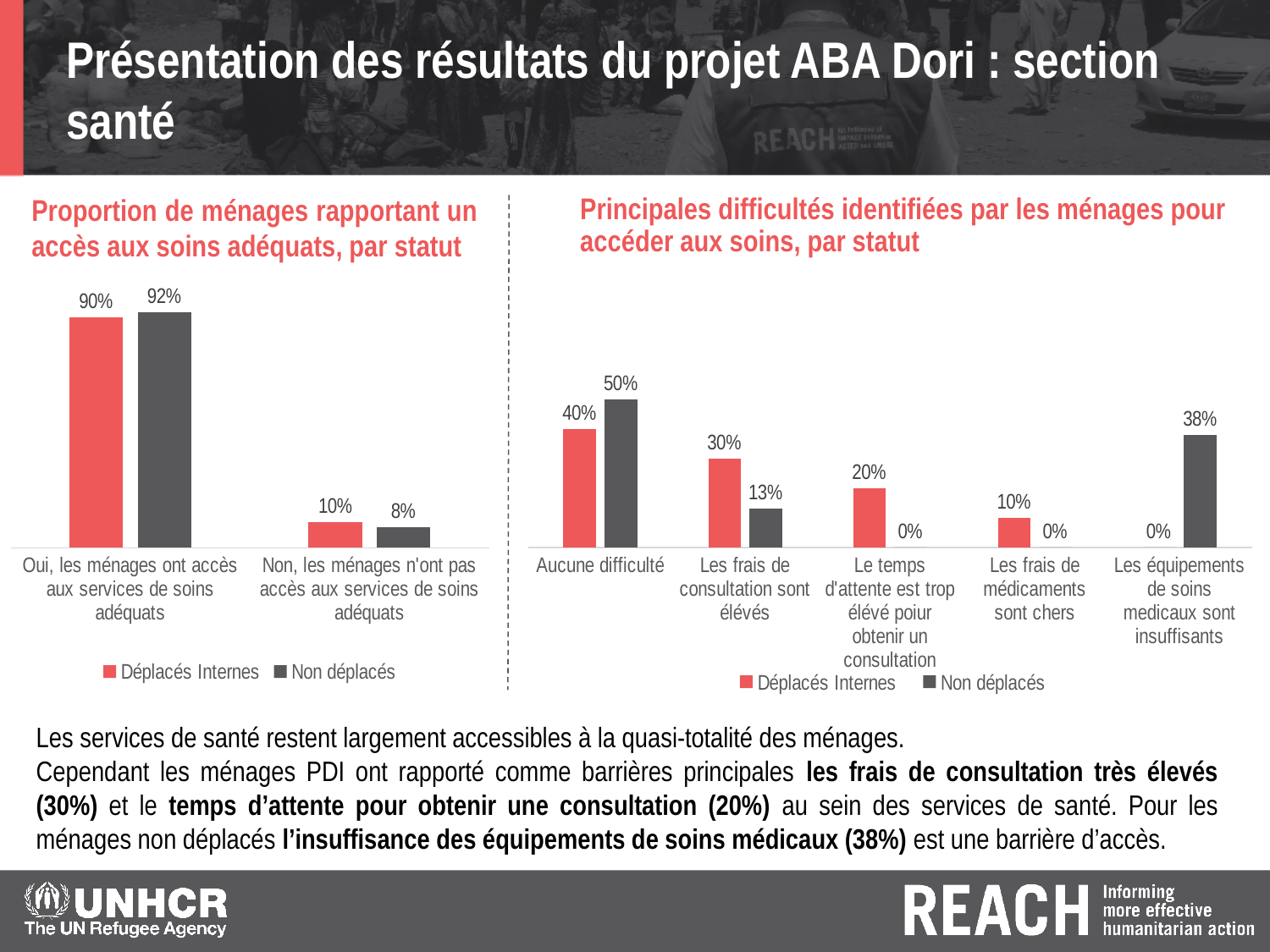
In the right chart (Principales difficultés identifiées par les ménages pour accéder aux soins, par statut), which category has the highest value for Non déplacés? Aucune difficulté In the right chart (Principales difficultés identifiées par les ménages pour accéder aux soins, par statut), which is larger for 'Les équipements de soins medicaux sont insuffisants': Déplacés Internes or Non déplacés? Non déplacés In the right chart (Principales difficultés identifiées par les ménages pour accéder aux soins, par statut), what is the value for Non déplacés for 'Aucune difficulté'? 50% In the right chart (Principales difficultés identifiées par les ménages pour accéder aux soins, par statut), which category has the highest value for Déplacés Internes? Aucune difficulté In the left chart (Proportion de ménages rapportant un accès aux soins adéquats, par statut), how many series does the legend list? 2 In the right chart (Principales difficultés identifiées par les ménages pour accéder aux soins, par statut), what is the value for Déplacés Internes for 'Les frais de consultation sont élévés'? 30% In the left chart (Proportion de ménages rapportant un accès aux soins adéquats, par statut), what is the value for Non déplacés for 'Non, les ménages n'ont pas accès aux services de soins adéquats'? 8% In the right chart (Principales difficultés identifiées par les ménages pour accéder aux soins, par statut), how many categories are shown on the x axis? 5 In the left chart (Proportion de ménages rapportant un accès aux soins adéquats, par statut), what is the difference between the Non déplacés and Déplacés Internes values for 'Oui, les ménages ont accès aux services de soins adéquats'? 2% What kind of chart is the right chart (Principales difficultés identifiées par les ménages pour accéder aux soins, par statut)? Bar chart In the right chart (Principales difficultés identifiées par les ménages pour accéder aux soins, par statut), what is the difference between the Déplacés Internes and Non déplacés values for 'Les frais de consultation sont élévés'? 17% In the left chart (Proportion de ménages rapportant un accès aux soins adéquats, par statut), what is the value for Déplacés Internes for 'Oui, les ménages ont accès aux services de soins adéquats'? 90%